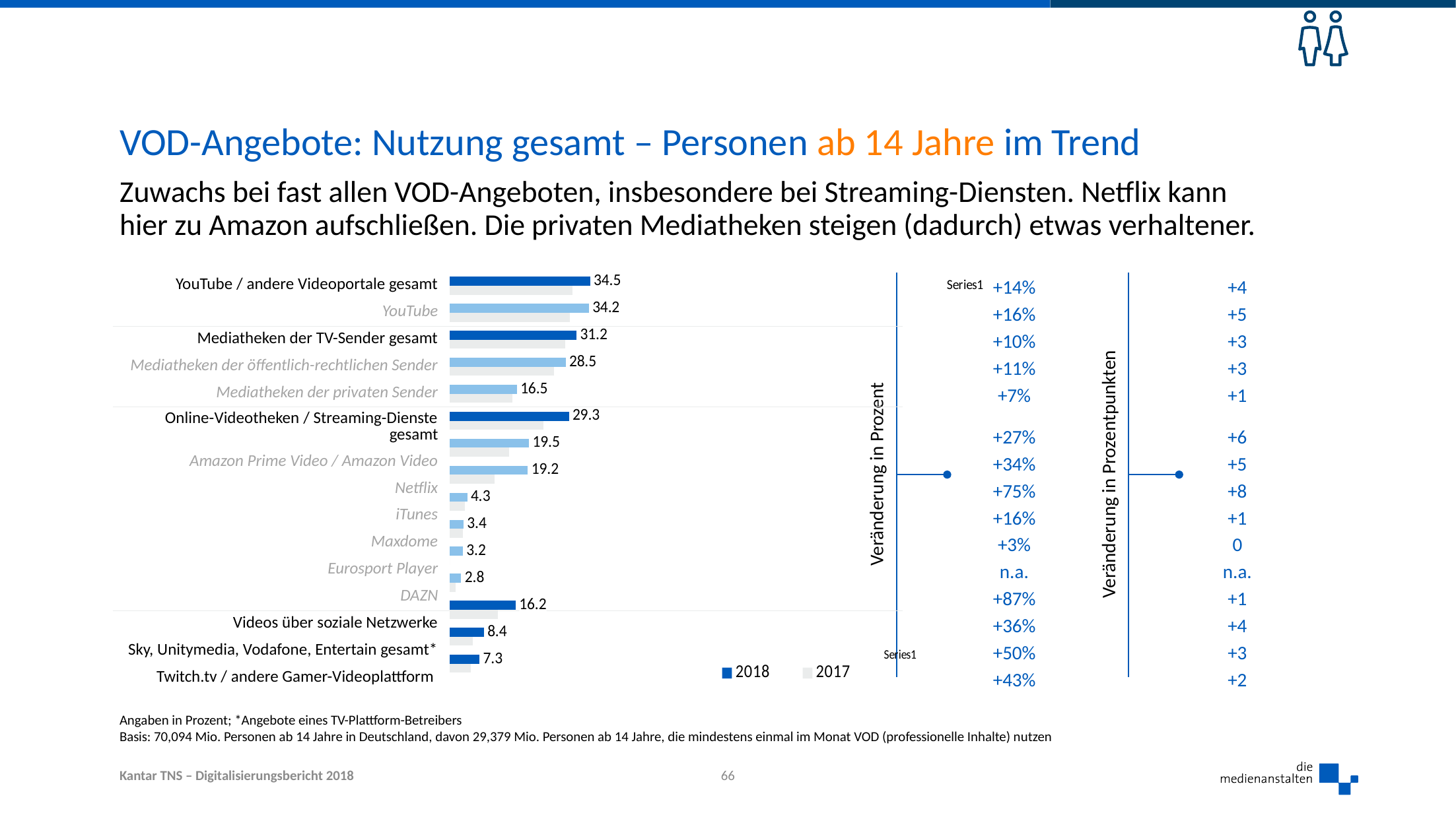
What is the 2018 value for Twitch.tv / andere Gamer-Videoplattform? 7.3 Which category has the lowest 2018 value? DAZN How many series does the legend list? 2 What is the difference between the 2018 values for Amazon Prime Video / Amazon Video and Netflix? 0.3 Which has the larger 2018 value: Mediatheken der TV-Sender gesamt or Online-Videotheken / Streaming-Dienste gesamt? Mediatheken der TV-Sender gesamt What is the 2018 value for Mediatheken der privaten Sender? 16.5 What is the 2018 value for YouTube / andere Videoportale gesamt? 34.5 What is the 2018 value for Netflix? 19.2 Which category has the highest 2018 value? YouTube / andere Videoportale gesamt How many categories are shown in the chart? 15 What is the difference between the 2018 values for YouTube / andere Videoportale gesamt and Mediatheken der TV-Sender gesamt? 3.3 What kind of chart is shown on the slide? Bar chart